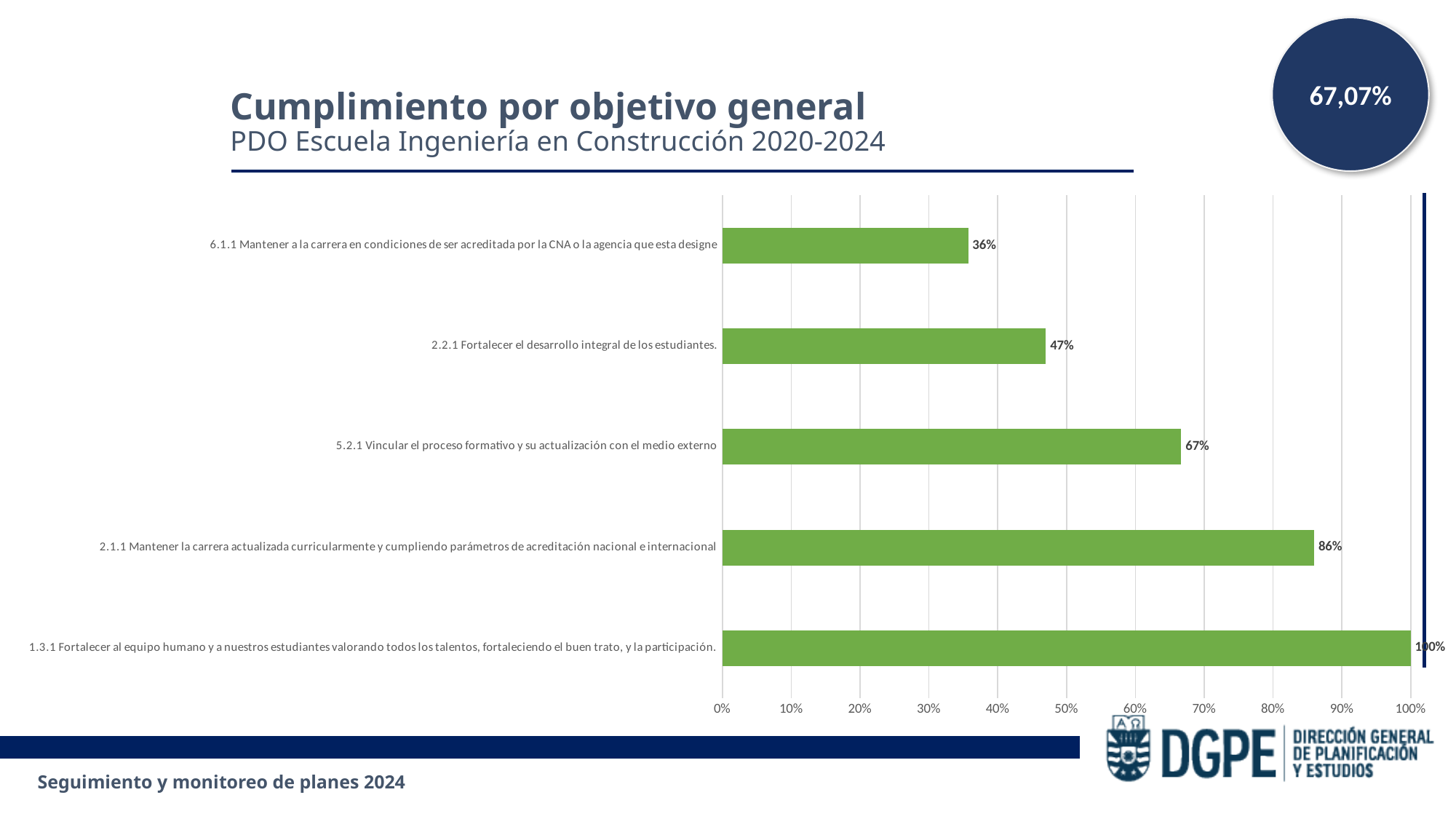
What overall percentage is shown in the circle at the top right of the slide? 67,07% What is the value for objective 2.1.1 (Mantener la carrera actualizada curricularmente y cumpliendo parámetros de acreditación nacional e internacional)? 86% What is the value for objective 5.2.1 (Vincular el proceso formativo y su actualización con el medio externo)? 67% Is the value for objective 2.1.1 greater or less than 80%? greater What is the difference between the values for objective 2.1.1 and objective 5.2.1? 19% Which objective has the highest value? 1.3.1 Fortalecer al equipo humano y a nuestros estudiantes valorando todos los talentos, fortaleciendo el buen trato, y la participación. Which is larger, the value for objective 2.2.1 or the value for objective 6.1.1? 2.2.1 Fortalecer el desarrollo integral de los estudiantes. Which objective has the lowest value? 6.1.1 Mantener a la carrera en condiciones de ser acreditada por la CNA o la agencia que esta designe How many objectives are shown in the chart? 5 What is the value for objective 6.1.1 (Mantener a la carrera en condiciones de ser acreditada por la CNA o la agencia que esta designe)? 36% What is the value for objective 2.2.1 (Fortalecer el desarrollo integral de los estudiantes)? 47% What kind of chart is shown on the slide? Bar chart